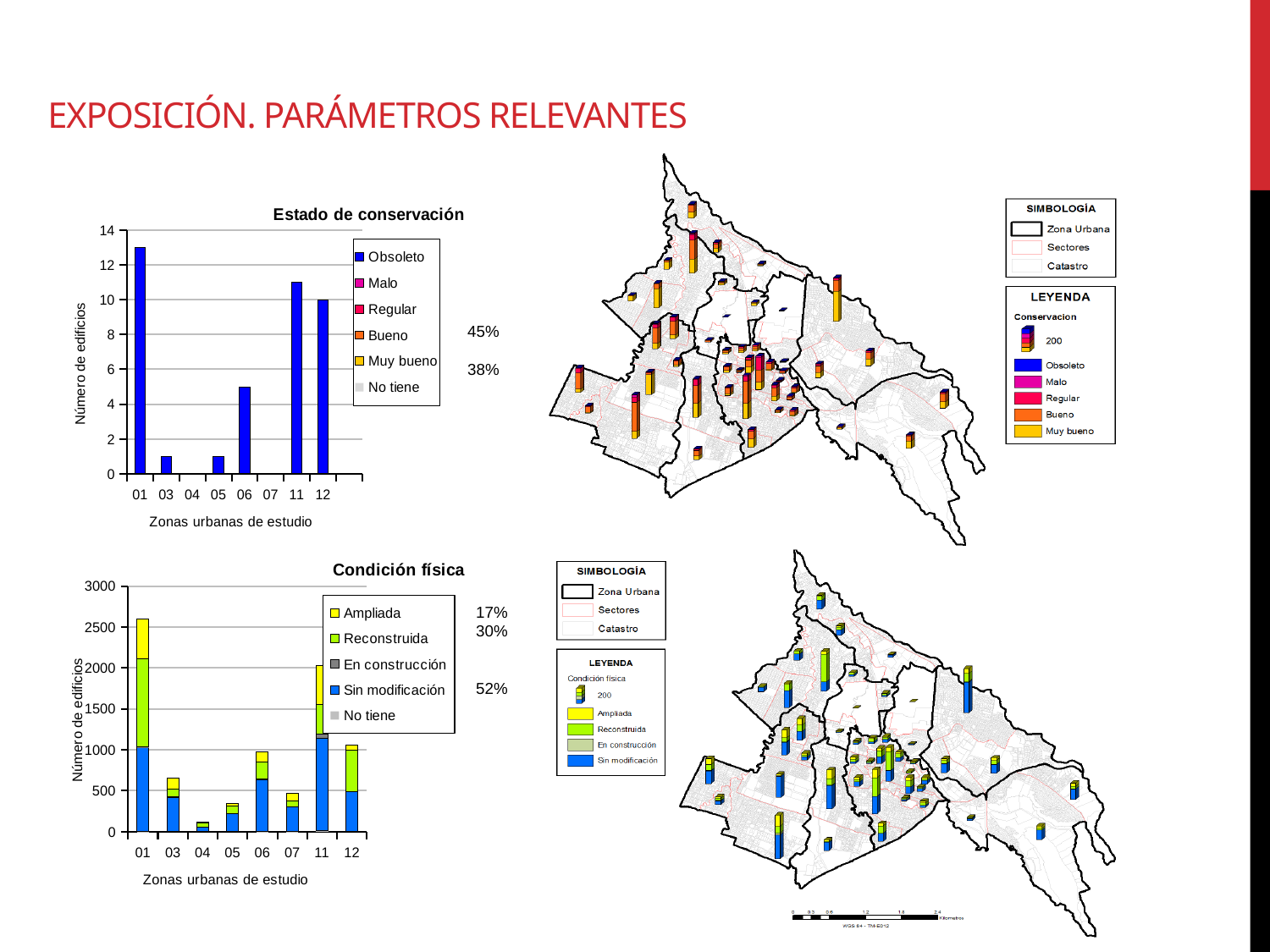
In the 'Condición física' chart, how many series does the legend list? 5 In the 'Estado de conservación' chart, what is the value for zone 12? 10 In the 'Estado de conservación' chart, which zone has the highest number of buildings? 01 In the 'Condición física' chart, is the total for zone 04 greater or less than 500? less In the 'Estado de conservación' chart, is the value for zone 01 greater or less than 12? greater What type of chart is the 'Estado de conservación' chart? bar chart In the 'Estado de conservación' chart, is the value for zone 03 greater or less than 2? less In the 'Condición física' chart, which zone has the tallest stacked bar? 01 What is the label of the x axis of the 'Condición física' chart? Zonas urbanas de estudio In the 'Estado de conservación' chart, how many zones are shown on the x axis? 8 In the 'Estado de conservación' chart, how many series does the legend list? 6